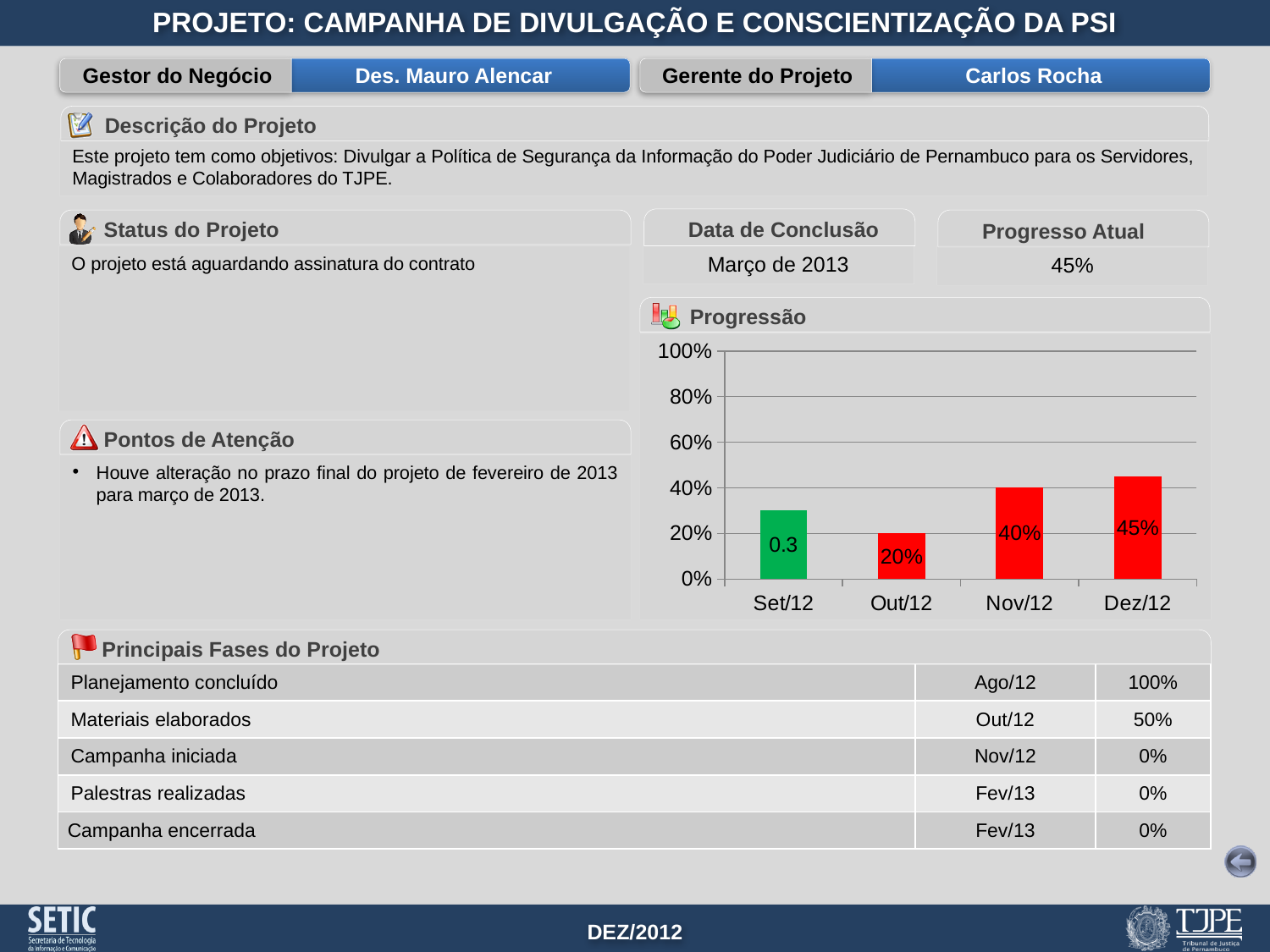
In the "Progressão" chart, what is the difference between the Dez/12 and Nov/12 values? 5% What is the data label shown on the Dez/12 bar in the "Progressão" chart? 45% What kind of chart is shown under "Progressão"? bar chart In the "Progressão" chart, is the value for Set/12 greater or less than 20%? greater What is the data label shown on the Set/12 bar in the "Progressão" chart? 0.3 How many months are plotted in the "Progressão" chart? 4 Which month has the highest bar in the "Progressão" chart? Dez/12 What is the data label shown on the Nov/12 bar in the "Progressão" chart? 40% Which month has the lowest bar in the "Progressão" chart? Out/12 What is the data label shown on the Out/12 bar in the "Progressão" chart? 20% What is the title of the chart on the slide? Progressão In the "Progressão" chart, do the values rise or fall from Out/12 to Dez/12? rise